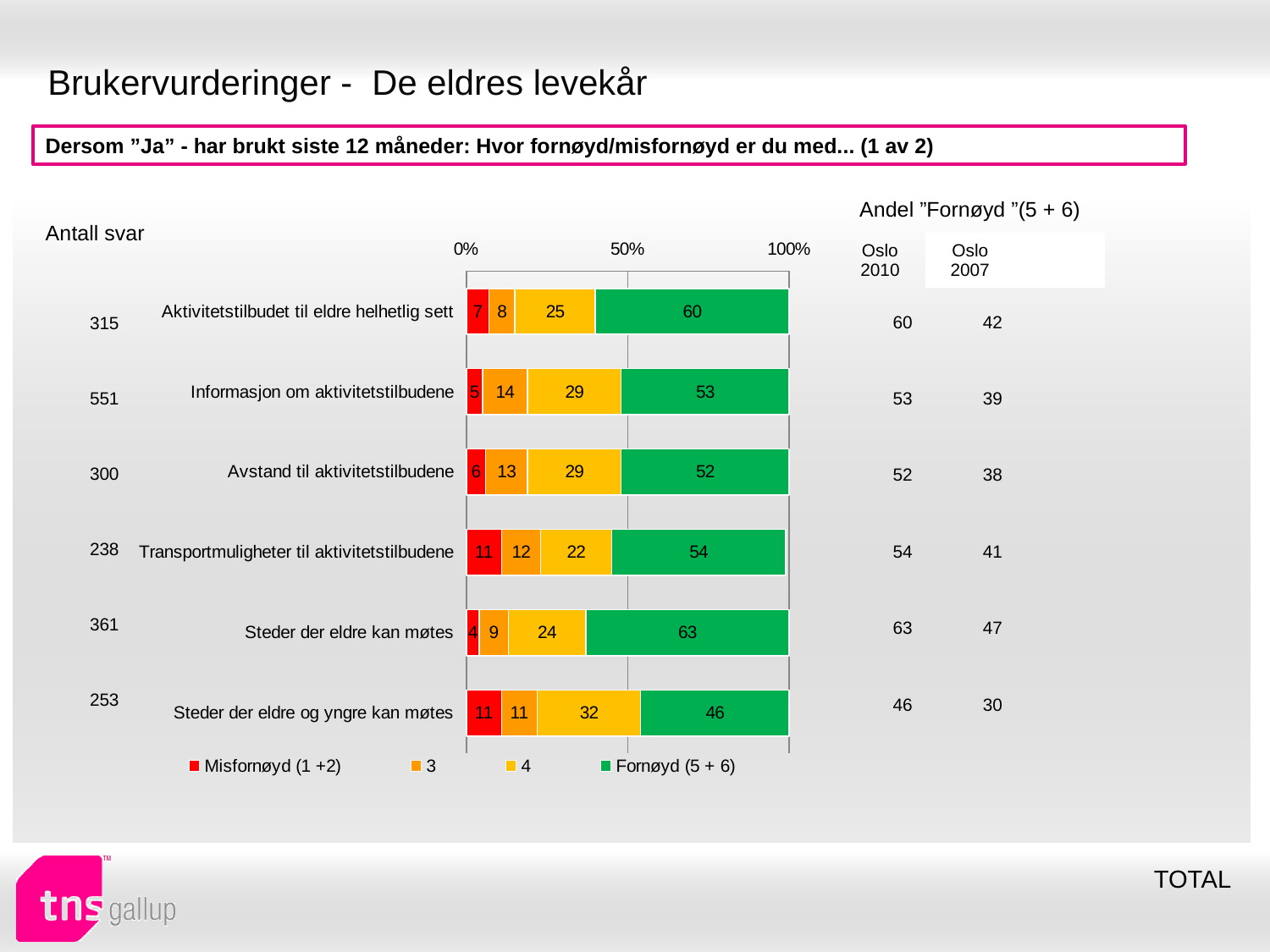
What is the value of the "4" segment for "Steder der eldre og yngre kan møtes"? 32 Which category has the highest "Fornøyd (5 + 6)" value? Steder der eldre kan møtes Which category has the lowest "Fornøyd (5 + 6)" value? Steder der eldre og yngre kan møtes How many series does the legend list? 4 What is the value of the "Misfornøyd (1 +2)" segment for "Transportmuligheter til aktivitetstilbudene"? 11 What is the total of the stacked bar for "Avstand til aktivitetstilbudene"? 100 How many categories are shown in the chart? 6 What is the value of the "Fornøyd (5 + 6)" segment for "Steder der eldre kan møtes"? 63 Which is larger: the "3" segment for "Informasjon om aktivitetstilbudene" or the "3" segment for "Aktivitetstilbudet til eldre helhetlig sett"? Informasjon om aktivitetstilbudene What kind of chart is shown on the slide? Stacked bar chart Which colour represents the "Fornøyd (5 + 6)" series in the chart? Green What is the difference between the "Fornøyd (5 + 6)" values for "Aktivitetstilbudet til eldre helhetlig sett" and "Steder der eldre og yngre kan møtes"? 14